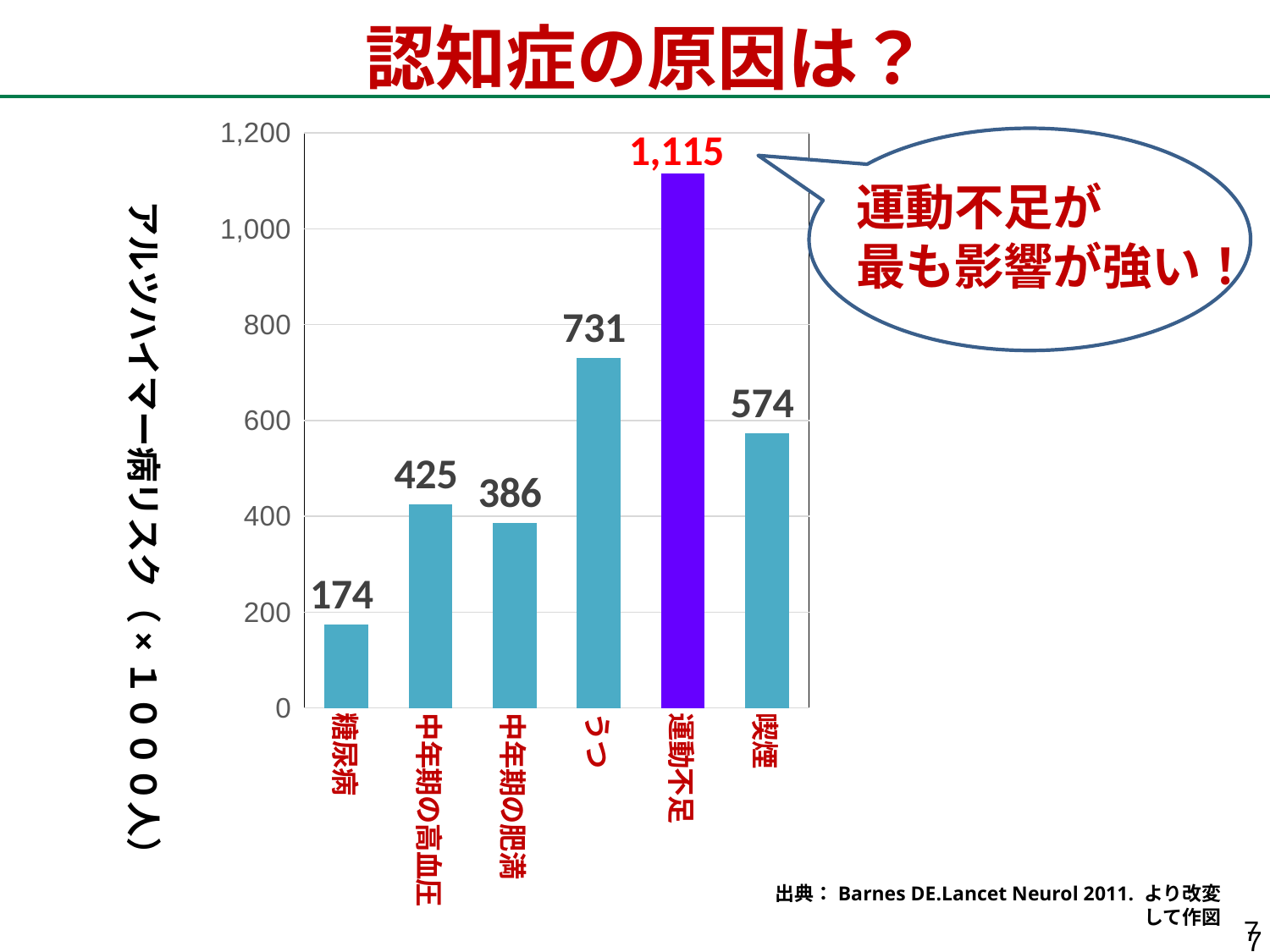
Which bar is coloured differently (purple) from the others? 運動不足 Which category has the highest value? 運動不足 What is the value for 喫煙? 574 What is the value for 運動不足? 1,115 What is the difference between the values for 中年期の高血圧 and 中年期の肥満? 39 Which is larger, the value for うつ or the value for 喫煙? うつ What kind of chart is this? bar chart What is the difference between the values for 運動不足 and うつ? 384 Which category has the lowest value? 糖尿病 What is the value for 中年期の高血圧? 425 What is the value for 糖尿病? 174 How many categories are shown on the x axis? 6